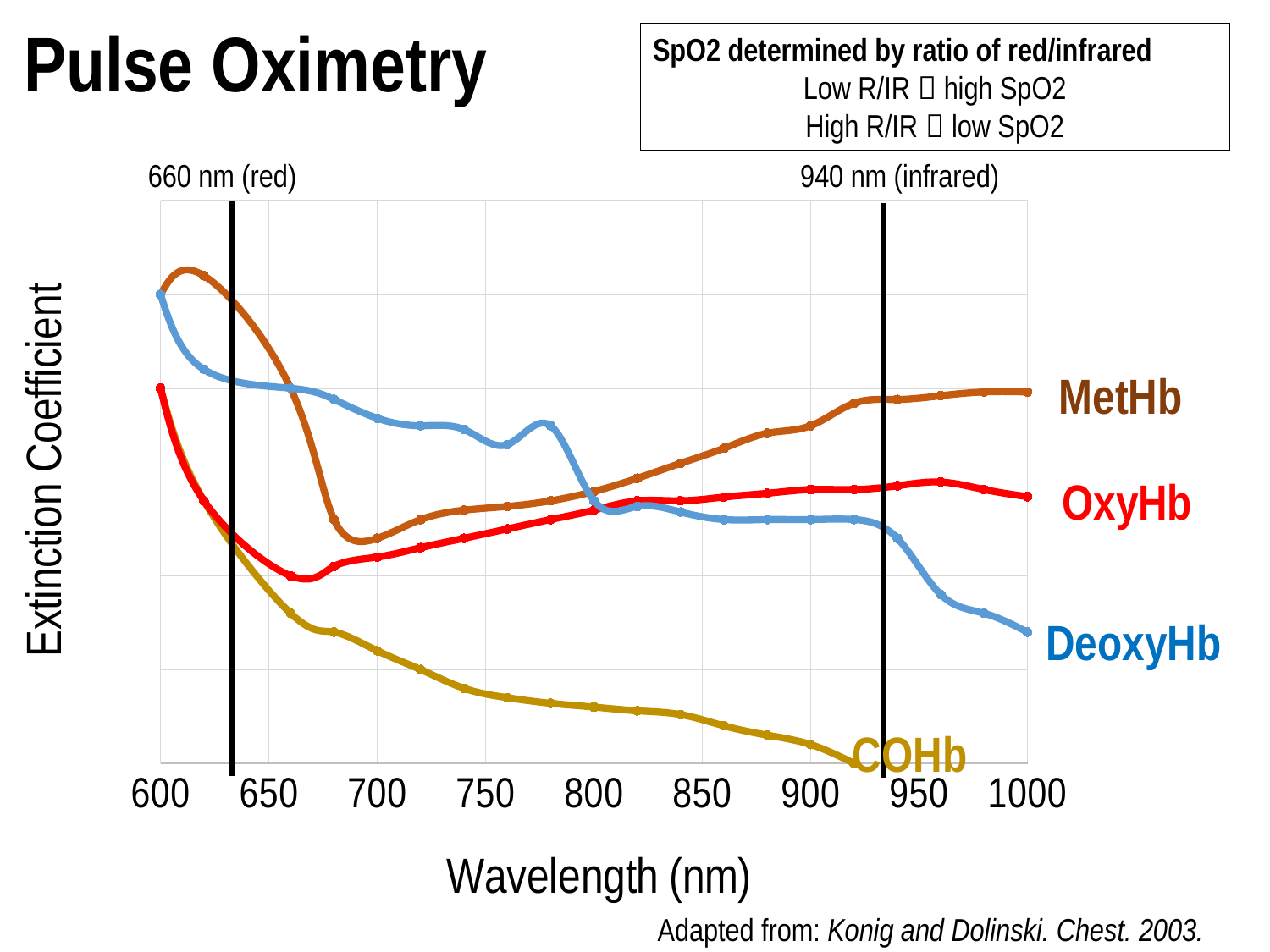
How many series are labelled on the chart? 4 Does the MetHb line rise or fall as wavelength increases from 700 nm to 1000 nm? rise What kind of chart is shown on the slide? line chart Which series has the lowest extinction coefficient at 800 nm? COHb How many tick labels are shown on the x axis of the chart? 9 What wavelength does the right-hand vertical black line mark on the chart? 940 nm (infrared) Does the COHb line rise or fall as wavelength increases from 600 nm to 900 nm? fall At 660 nm, which series has the higher extinction coefficient, OxyHb or DeoxyHb? DeoxyHb At 940 nm, which series has the higher extinction coefficient, OxyHb or DeoxyHb? OxyHb What is the title of the x axis of the chart? Wavelength (nm) Which series has the lowest extinction coefficient at 900 nm? COHb Which series has the highest extinction coefficient at 1000 nm? MetHb